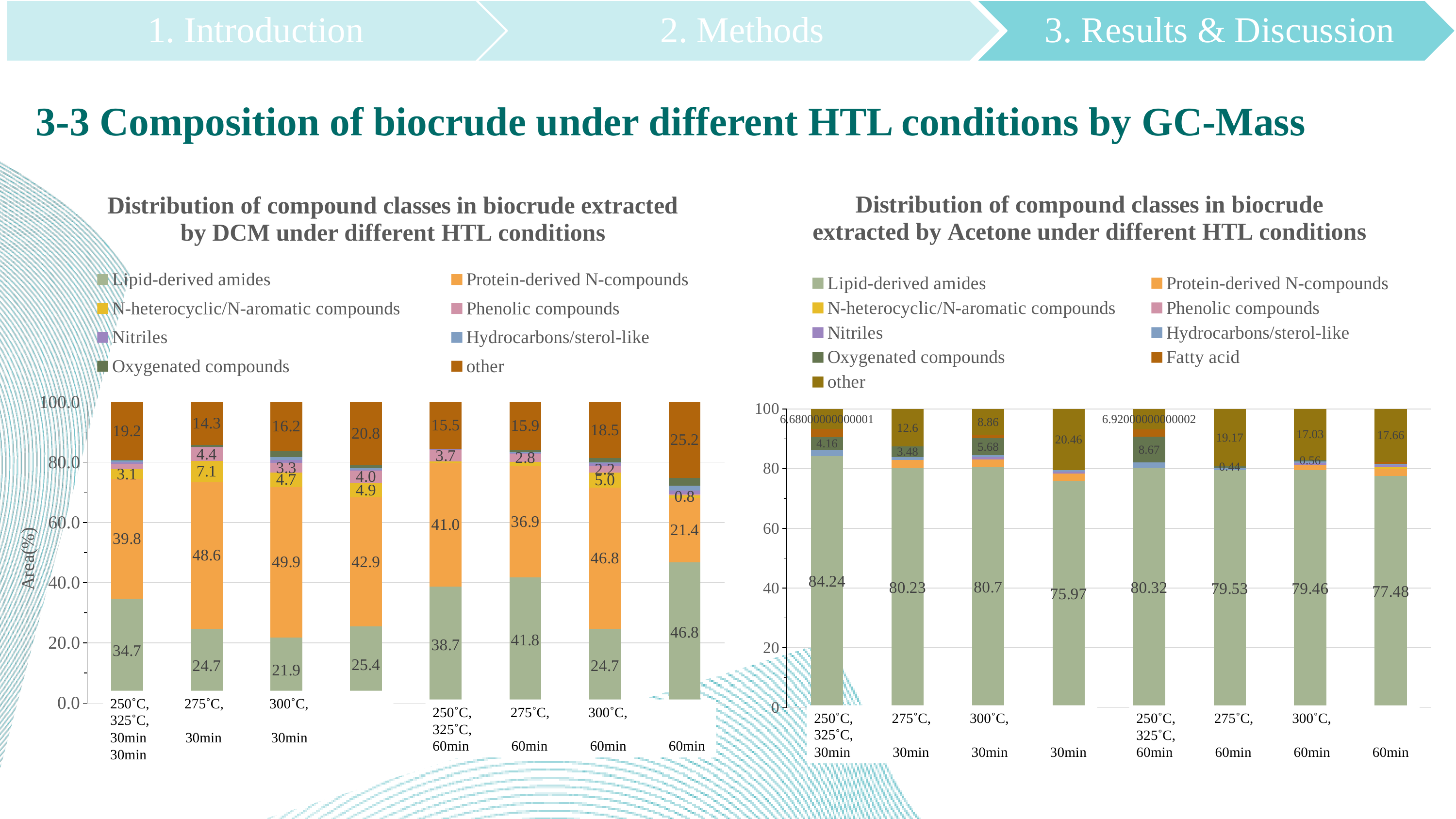
In the right chart (Acetone), what is the lowest Lipid-derived amides value shown? 75.97 In the right chart (Acetone), what is the highest Lipid-derived amides value shown? 84.24 In the right chart (Acetone), what is the Lipid-derived amides value for the 275˚C, 60min bar? 79.53 In the left chart (DCM), what is the Lipid-derived amides value for the 275˚C, 30min bar? 24.7 In the left chart (DCM), which bar has the larger Lipid-derived amides value: 275˚C, 60min or 300˚C, 60min? 275˚C, 60min How many stacked bars are plotted in the left chart (DCM)? 8 In the left chart (DCM), what is the 'other' value for the 300˚C, 30min bar? 16.2 In the left chart (DCM), what is the Protein-derived N-compounds value for the 300˚C, 30min bar? 49.9 In the left chart (DCM), what is the difference between the Protein-derived N-compounds value at 275˚C, 30min and at 300˚C, 60min? 1.8 What kind of chart is the left chart, 'Distribution of compound classes in biocrude extracted by DCM under different HTL conditions'? Stacked bar chart How many series does the legend of the left chart (DCM) list? 8 How many series does the legend of the right chart (Acetone) list? 9